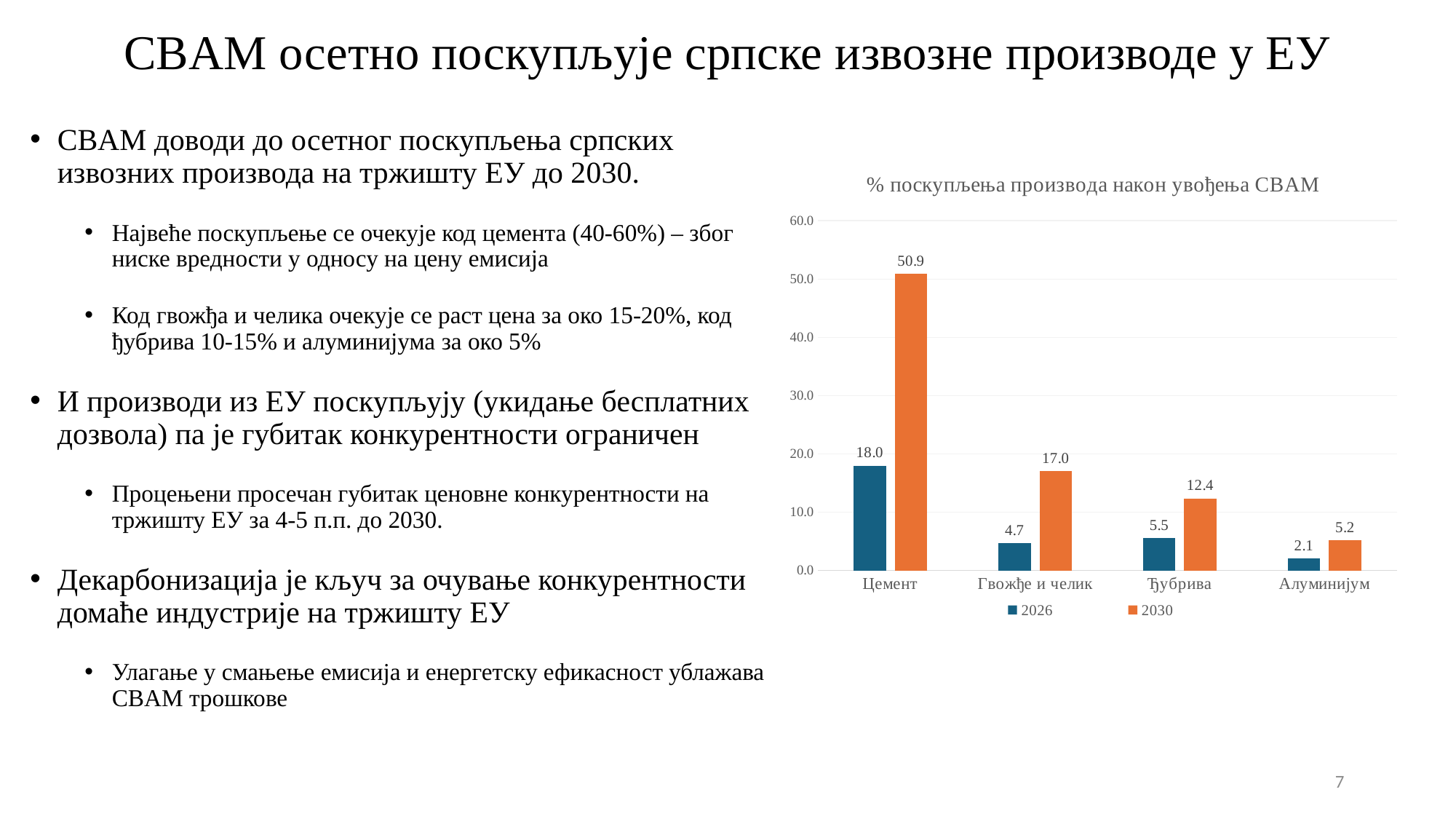
How many categories are shown on the x axis? 4 What type of chart is shown on the slide? bar chart Is the 2030 value for Цемент greater or less than 40.0? greater What is the value for Гвожђе и челик in the 2026 series? 4.7 Which category has the lowest value in the 2026 series? Алуминијум Which category has the highest value in the 2030 series? Цемент What is the value for Цемент in the 2030 series? 50.9 What is the difference between the 2030 and 2026 values for Цемент? 32.9 What is the difference between the 2030 and 2026 values for Ђубрива? 6.9 What is the value for Алуминијум in the 2030 series? 5.2 How many series does the legend list? 2 Which is larger: the 2026 value for Ђубрива or the 2026 value for Гвожђе и челик? Ђубрива